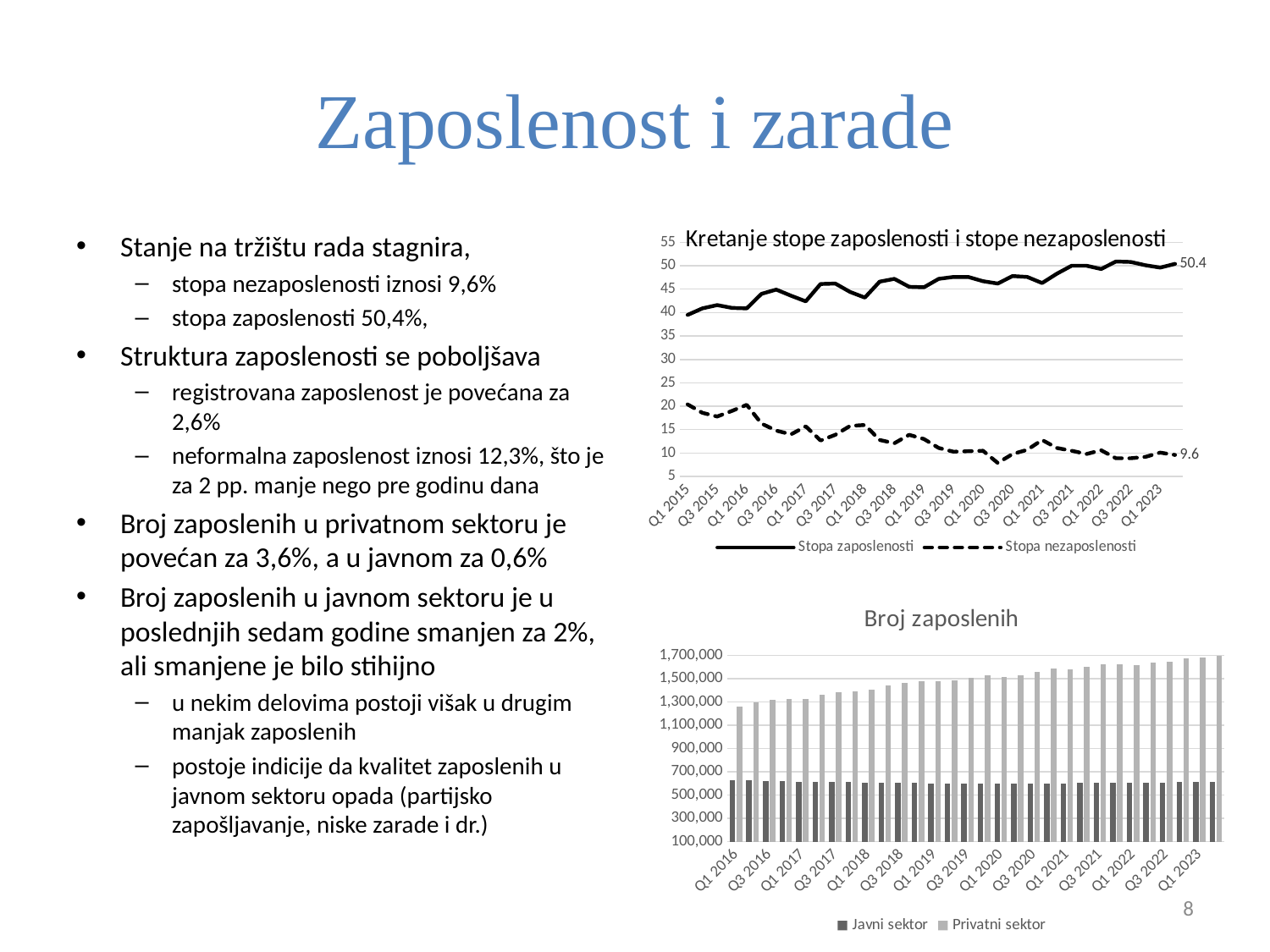
In the chart titled 'Kretanje stope zaposlenosti i stope nezaposlenosti', which series is drawn with a dashed line? Stopa nezaposlenosti In the chart titled 'Broj zaposlenih', what type of chart is used? Bar chart In the chart titled 'Kretanje stope zaposlenosti i stope nezaposlenosti', how many series does the legend list? 2 In the chart titled 'Broj zaposlenih', is the Privatni sektor value at Q1 2016 greater or less than 1,100,000? greater In the chart titled 'Kretanje stope zaposlenosti i stope nezaposlenosti', what is the difference between the two labelled end values, 50.4 and 9.6? 40.8 In the chart titled 'Kretanje stope zaposlenosti i stope nezaposlenosti', what type of chart is used? Line chart In the chart titled 'Kretanje stope zaposlenosti i stope nezaposlenosti', what is the last labelled value of the Stopa zaposlenosti series? 50.4 In the chart titled 'Broj zaposlenih', which series has the larger value at Q1 2023, Javni sektor or Privatni sektor? Privatni sektor In the chart titled 'Kretanje stope zaposlenosti i stope nezaposlenosti', does the Stopa nezaposlenosti series generally rise or fall from Q1 2015 to Q1 2023? Fall In the chart titled 'Kretanje stope zaposlenosti i stope nezaposlenosti', does the Stopa zaposlenosti series generally rise or fall from Q1 2015 to Q1 2023? Rise In the chart titled 'Kretanje stope zaposlenosti i stope nezaposlenosti', what is the last labelled value of the Stopa nezaposlenosti series? 9.6